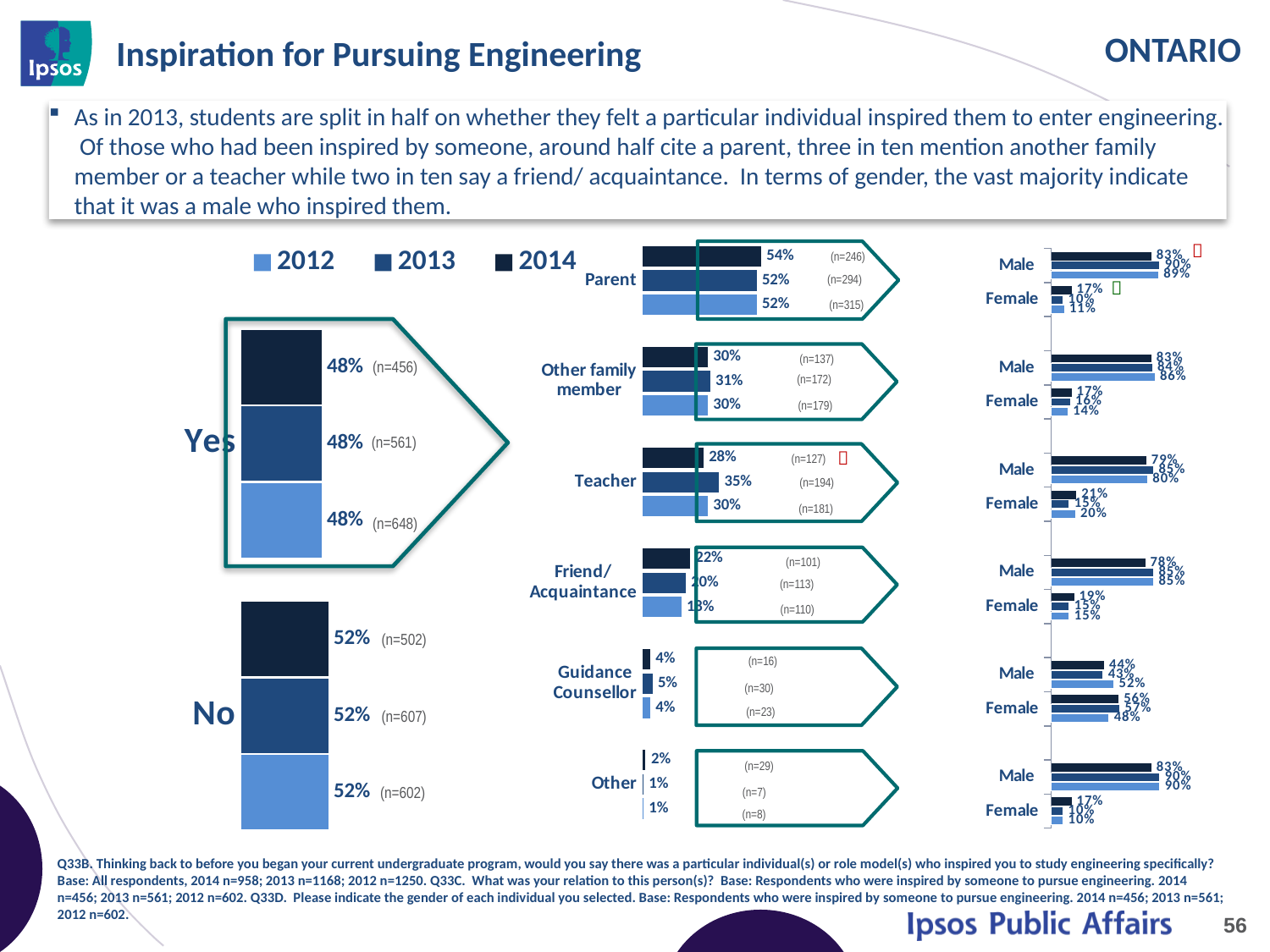
In the middle chart showing relation to the inspiring person, what percentage cited a friend/acquaintance in 2012? 18% In the middle chart showing relation to the inspiring person, what is the difference between the 2014 values for Parent and Other family member? 24 percentage points What type of chart is the Yes/No chart on the left of the slide? Bar chart In the middle chart showing relation to the inspiring person, which category has the lowest 2014 value? Other In the middle chart showing relation to the inspiring person, what percentage cited a teacher in 2013? 35% In the Yes/No chart on the left, what percentage answered Yes in 2014? 48% In the middle chart showing relation to the inspiring person, how many relation categories are shown? 6 In the middle chart showing relation to the inspiring person, which category has the highest 2014 value? Parent In the middle chart showing relation to the inspiring person, what percentage cited a parent in 2014? 54% How many years does the legend at the top of the slide list? 3 In the middle chart showing relation to the inspiring person, did the Friend/Acquaintance value rise or fall from 2012 to 2014? Rise In the middle chart showing relation to the inspiring person, which had the larger 2013 value: Teacher or Friend/Acquaintance? Teacher